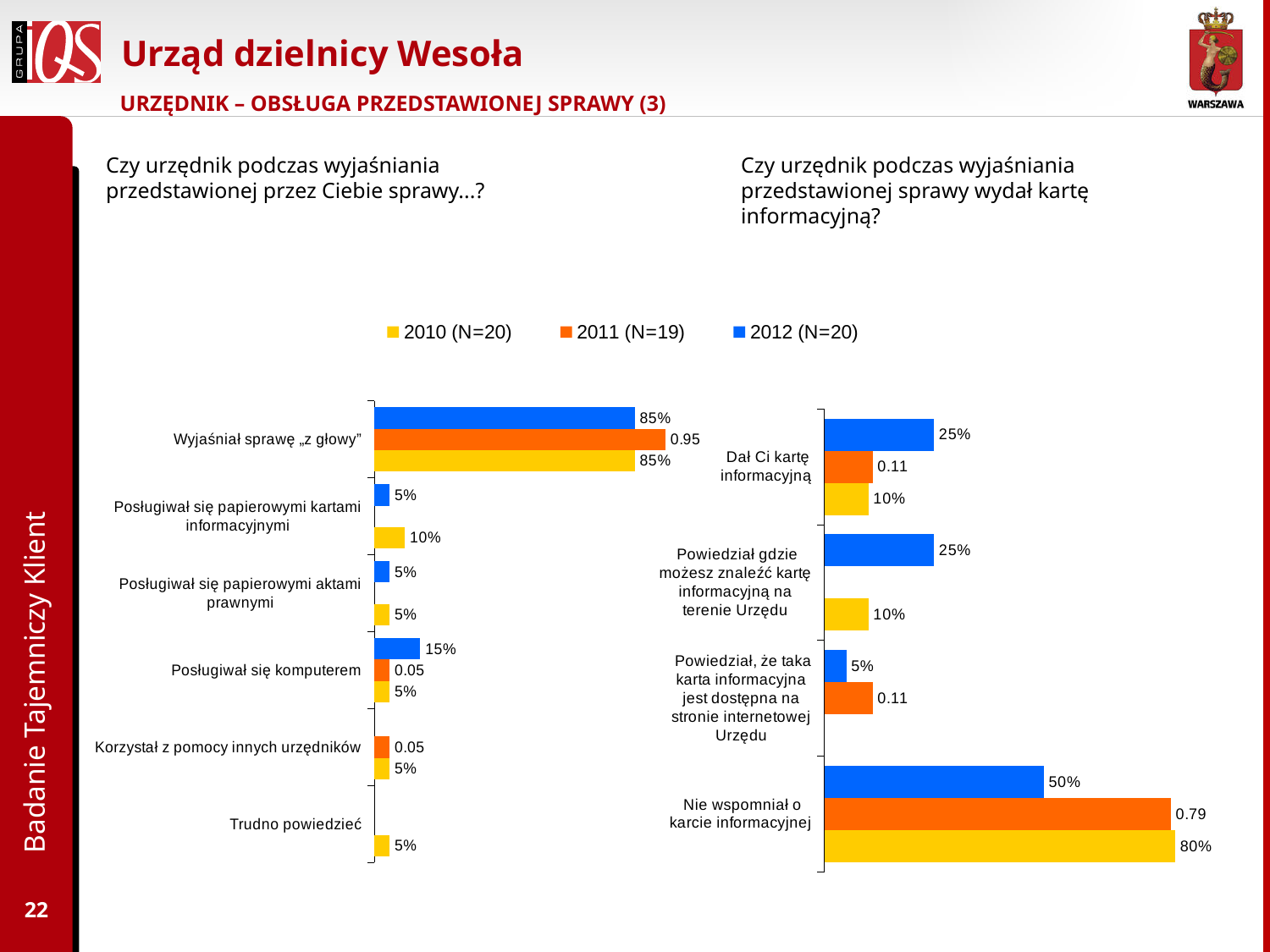
In the right chart, which category has the highest 2012 (N=20) value? Nie wspomniał o karcie informacyjnej In the right chart, what is the 2011 (N=19) value for "Dał Ci kartę informacyjną"? 0.11 In the right chart, what is the 2010 (N=20) value for "Nie wspomniał o karcie informacyjnej"? 80% In the left chart, what is the 2010 (N=20) value for "Posługiwał się papierowymi kartami informacyjnymi"? 10% In the right chart, what is the difference between the 2010 (N=20) and 2012 (N=20) values for "Nie wspomniał o karcie informacyjnej"? 30% In the left chart, what is the 2012 (N=20) value for "Wyjaśniał sprawę „z głowy”"? 85% How many series does the legend list? 3 In the left chart, what is the 2011 (N=19) value for "Wyjaśniał sprawę „z głowy”"? 0.95 In the left chart, what is the 2012 (N=20) value for "Posługiwał się komputerem"? 15% What kind of chart is the right chart? Bar chart How many categories does the left chart show? 6 In the right chart, which is larger for "Dał Ci kartę informacyjną": the 2012 (N=20) value or the 2010 (N=20) value? 2012 (N=20)